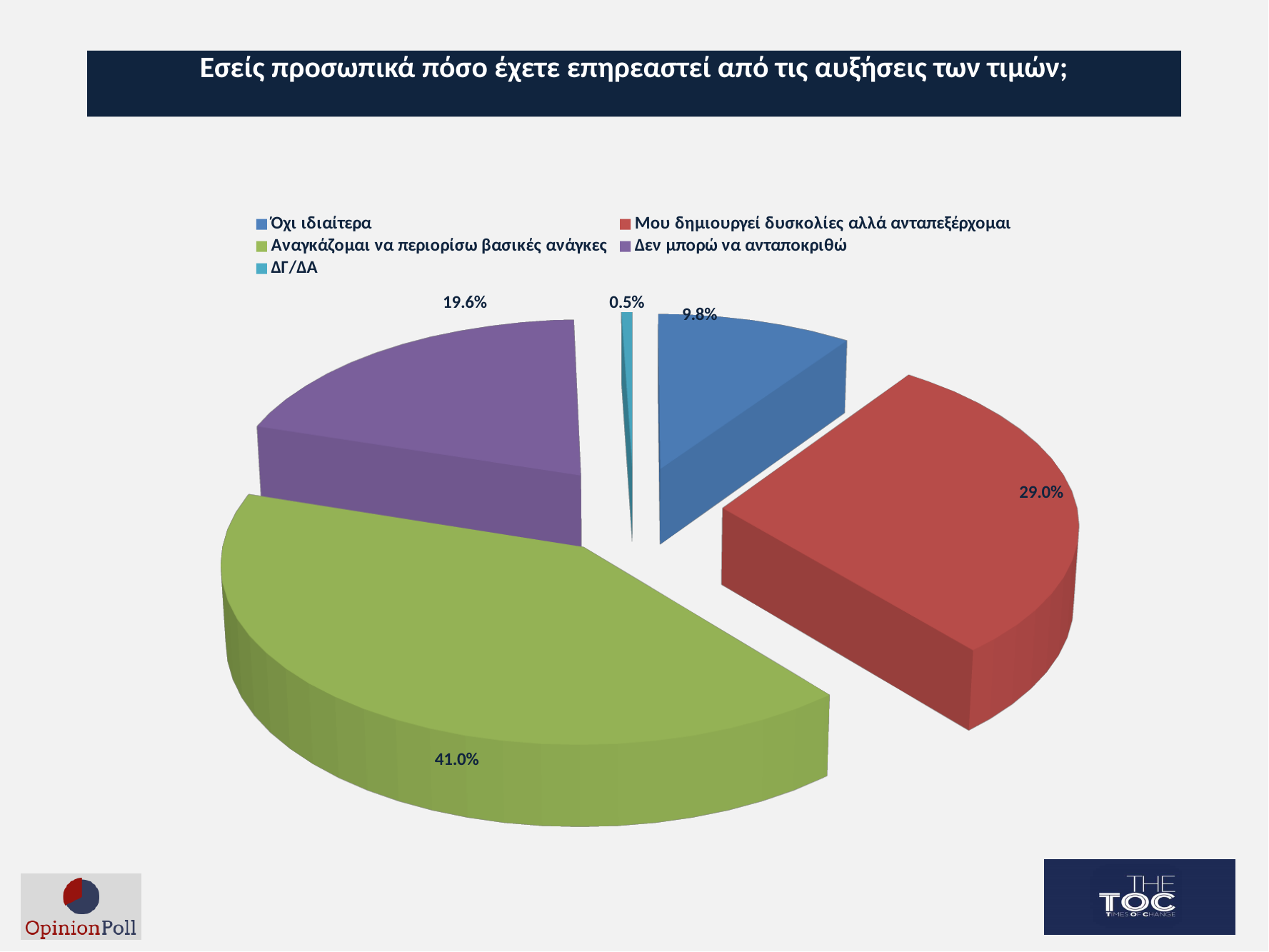
What is the value for "Αναγκάζομαι να περιορίσω βασικές ανάγκες"? 41.0% What is the value for "ΔΓ/ΔΑ"? 0.5% How many categories does the pie chart have? 5 What is the value for "Όχι ιδιαίτερα"? 9.8% What is the difference between the values for "Αναγκάζομαι να περιορίσω βασικές ανάγκες" and "Μου δημιουργεί δυσκολίες αλλά ανταπεξέρχομαι"? 12.0% Which is larger, the value for "Δεν μπορώ να ανταποκριθώ" or the value for "Όχι ιδιαίτερα"? Δεν μπορώ να ανταποκριθώ Which category has the smallest share of the pie? ΔΓ/ΔΑ What is the value for "Μου δημιουργεί δυσκολίες αλλά ανταπεξέρχομαι"? 29.0% Which category has the largest share of the pie? Αναγκάζομαι να περιορίσω βασικές ανάγκες What is the value for "Δεν μπορώ να ανταποκριθώ"? 19.6% What colour is the slice for "Δεν μπορώ να ανταποκριθώ"? Purple What type of chart is shown on the slide? Pie chart